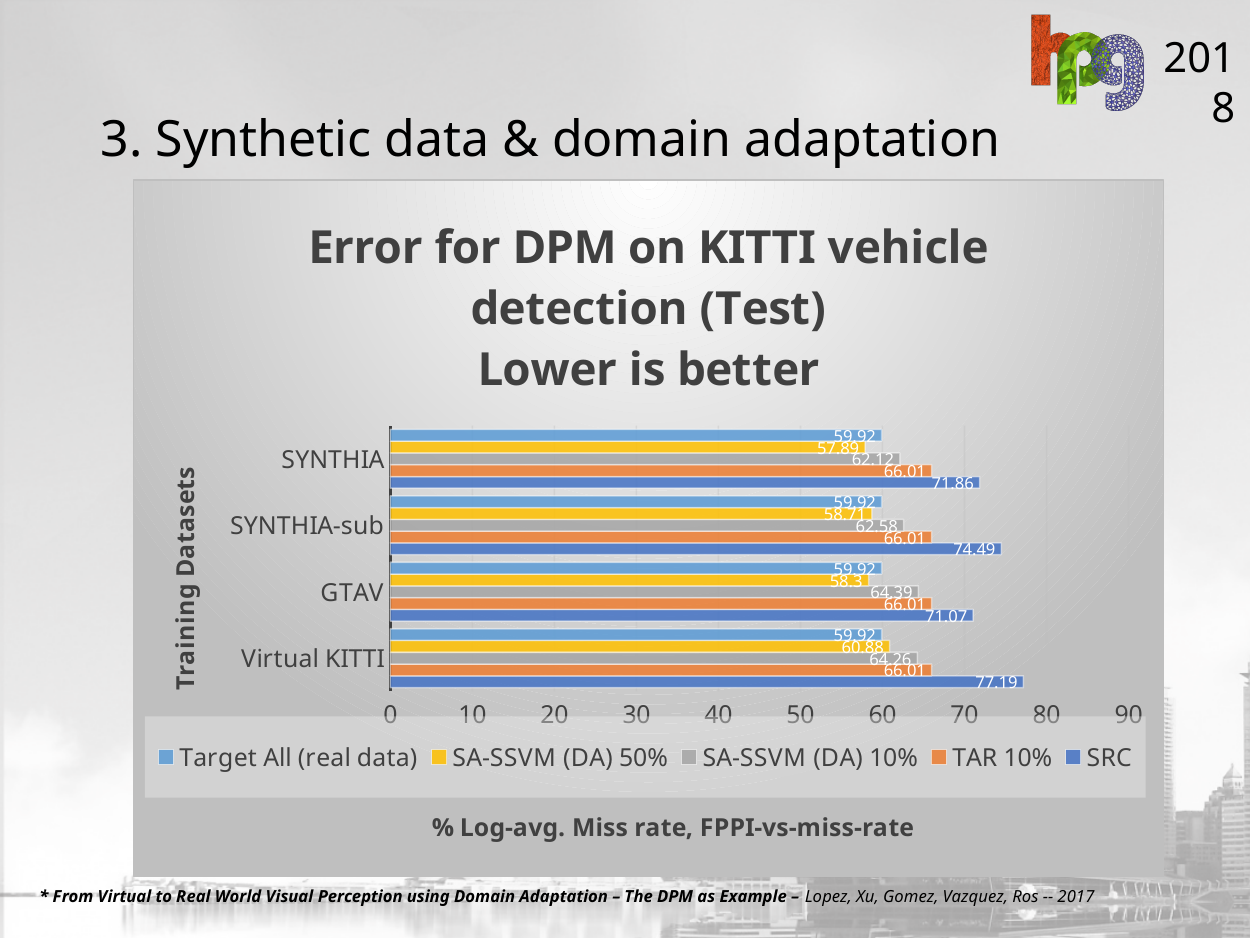
Is the SRC value for SYNTHIA greater or less than 70? greater What is the difference between the SRC value and the Target All (real data) value for SYNTHIA-sub? 14.57 What is the SRC value for Virtual KITTI? 77.19 Which training dataset has the highest SRC value? Virtual KITTI What is the SA-SSVM (DA) 50% value for SYNTHIA? 57.89 Which training dataset has the lowest SA-SSVM (DA) 50% value? SYNTHIA Which is larger for GTAV: the SRC value or the TAR 10% value? SRC What type of chart is shown? Bar chart What is the SA-SSVM (DA) 10% value for GTAV? 64.39 How many series does the legend list? 5 What is the TAR 10% value for SYNTHIA-sub? 66.01 How many training datasets are shown on the y axis? 4